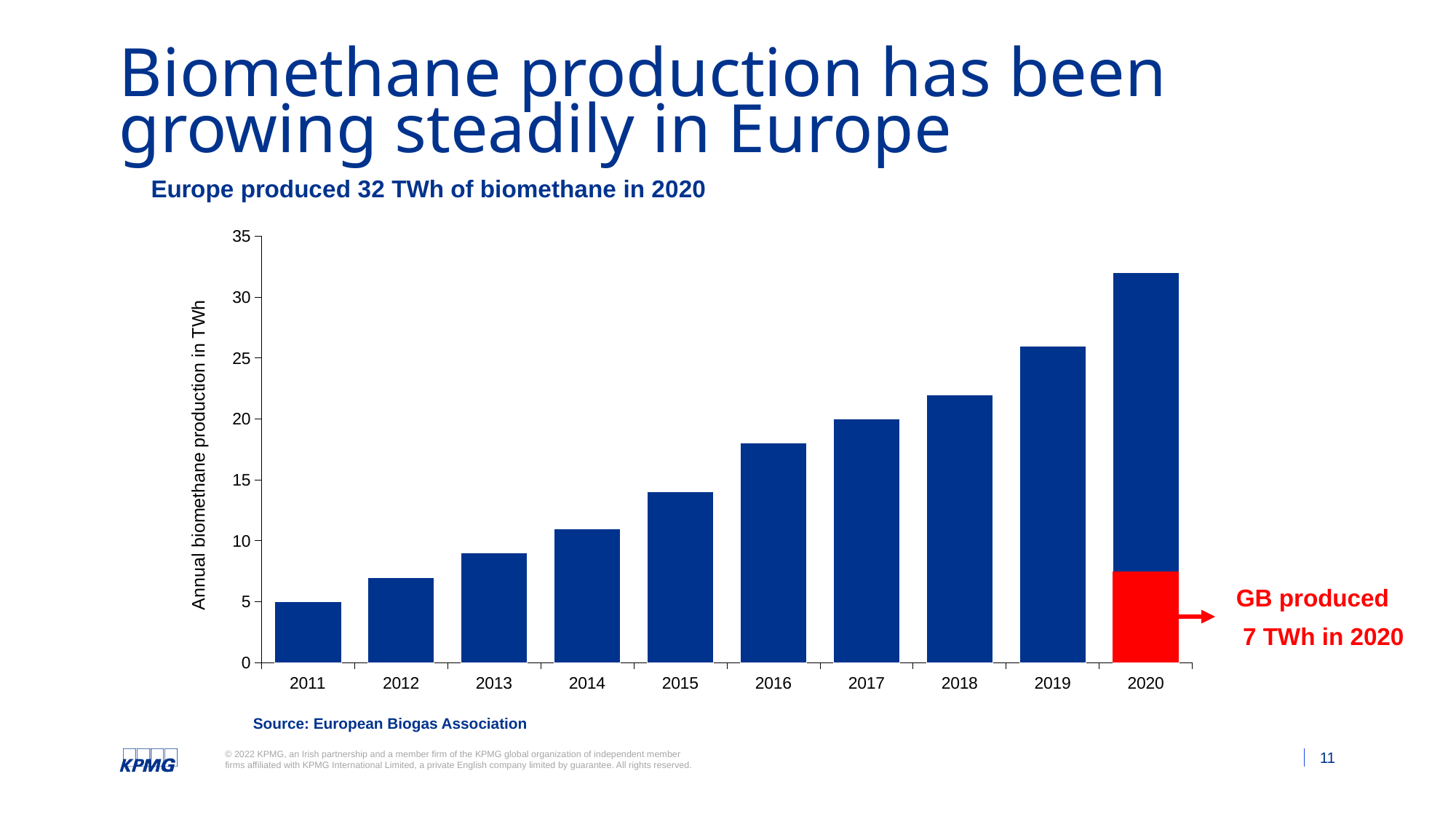
Which year has the highest annual biomethane production? 2020 What kind of chart is shown on the slide? Bar chart Which year has the larger annual biomethane production, 2016 or 2018? 2018 How much biomethane did GB produce in 2020 according to the slide? 7 TWh Is the value for 2015 greater or less than 15? less Do the values rise or fall from 2011 to 2020? Rise How much biomethane did Europe produce in 2020 according to the slide? 32 TWh Is the value for 2013 greater or less than 10? less How many years are shown on the x axis of the chart? 10 What is the difference between Europe's total biomethane production in 2020 and GB's production in 2020? 25 TWh Which year has the lowest annual biomethane production? 2011 Is the value for 2019 greater or less than 25? greater